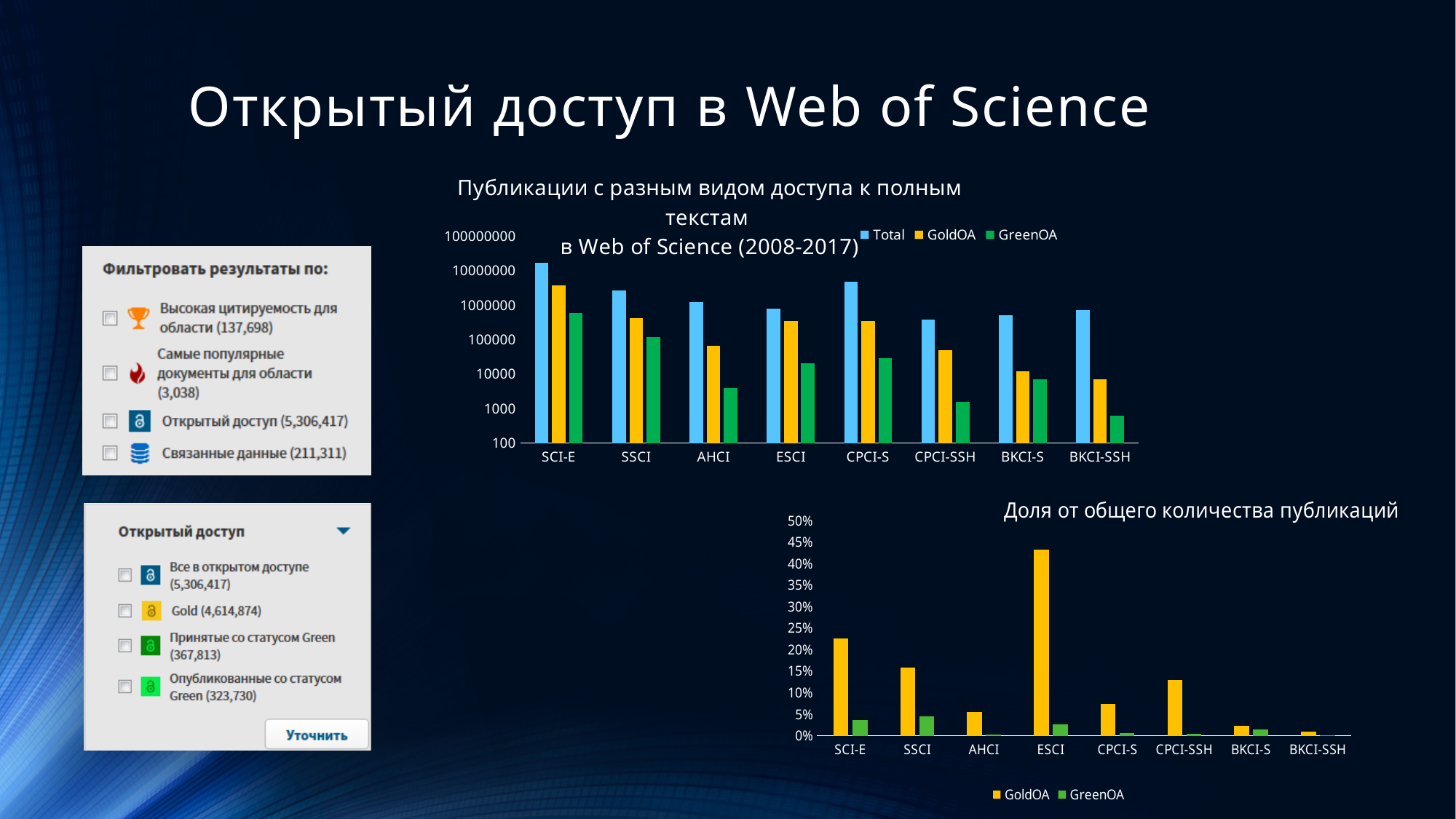
In the top chart, which category has the highest Total value? SCI-E In the top chart, is the Total value for SCI-E greater or less than 10000000? greater In the top chart, which category has the lowest GreenOA value? BKCI-SSH In the bottom chart 'Доля от общего количества публикаций', is the GoldOA value for ESCI greater or less than 40%? greater In the bottom chart 'Доля от общего количества публикаций', which category has the highest GoldOA share? ESCI How many series does the legend of the bottom chart 'Доля от общего количества публикаций' list? 2 In the bottom chart 'Доля от общего количества публикаций', which is larger: the GoldOA value for SCI-E or the GoldOA value for SSCI? SCI-E What type of chart is the top chart titled 'Публикации с разным видом доступа к полным текстам в Web of Science (2008-2017)'? bar chart In the top chart, is the GreenOA value for AHCI greater or less than 10000? less How many categories are shown on the x axis of the top chart? 8 In the top chart, which is larger: the Total value for SSCI or the Total value for AHCI? SSCI How many series does the legend of the top chart list? 3